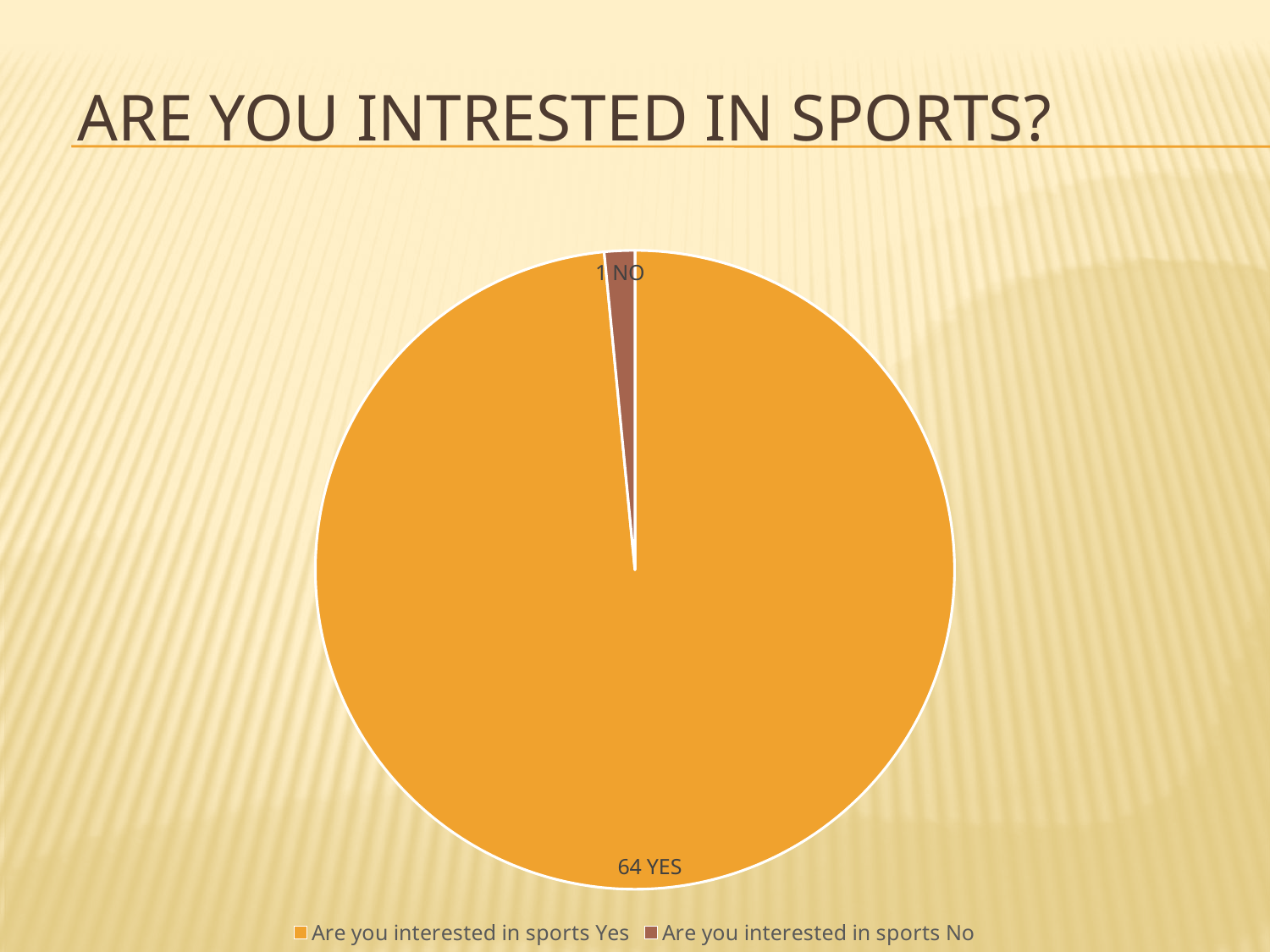
What type of chart is shown on the slide? pie chart How many people answered No to being interested in sports? 1 Which response has the smallest slice of the pie? No Which is larger, the number of Yes responses or the number of No responses? Yes How many slices does the pie chart have? 2 What is the difference between the number of Yes and No responses? 63 Which response has the largest slice of the pie? Yes How many entries does the legend list? 2 What is the title of the slide containing the chart? ARE YOU INTRESTED IN SPORTS? How many people answered Yes to being interested in sports? 64 What colour is the slice for the No responses? brown What is the total number of responses shown in the pie chart? 65